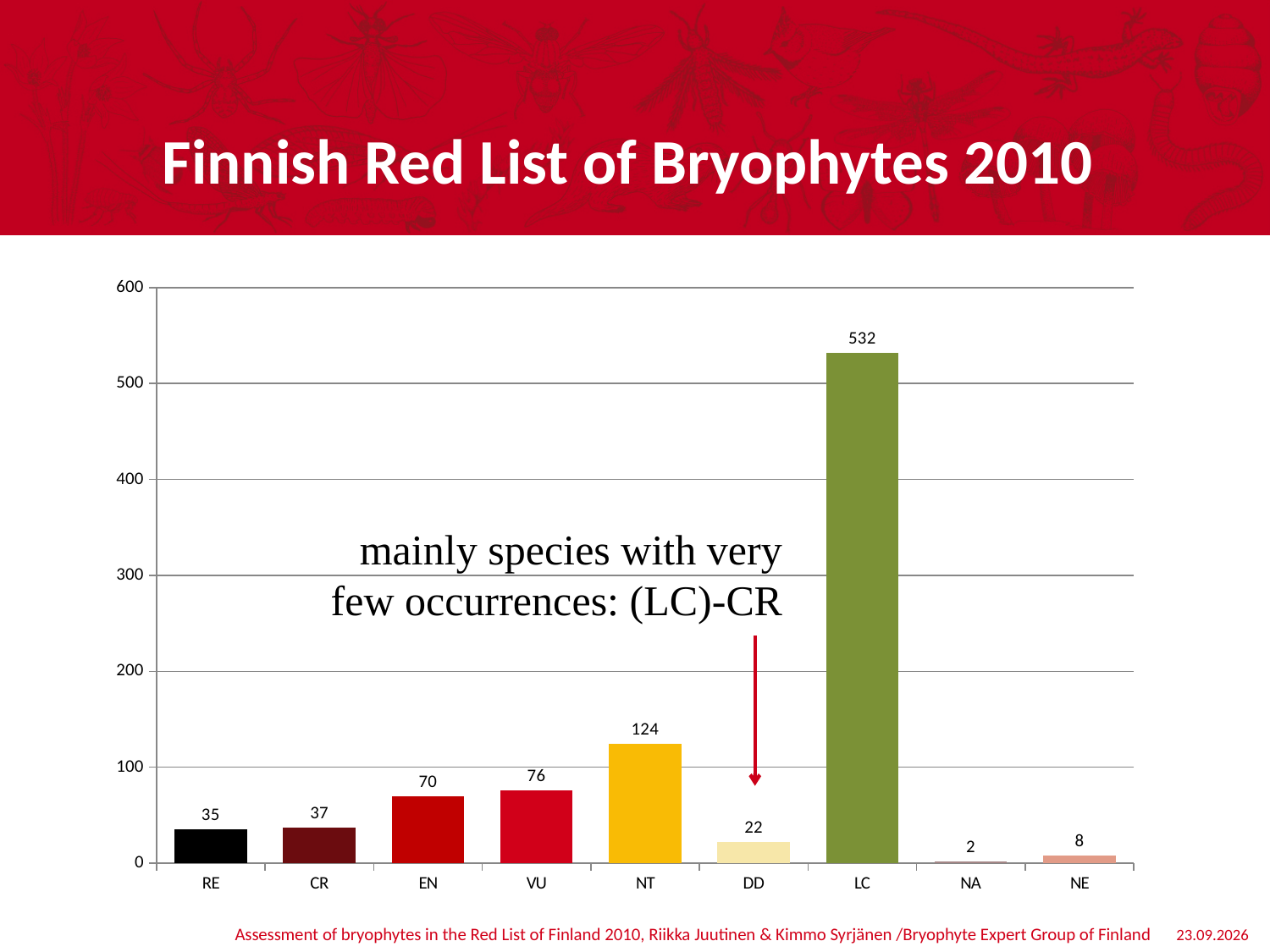
What colour is the bar for LC? green What is the value for NT? 124 What is the total of the values for RE and CR? 72 How many categories are shown on the x axis? 9 What is the value for DD? 22 What is the value for LC? 532 Which category has the lowest value? NA What kind of chart is shown on the slide? bar chart What is the difference between the values for VU and EN? 6 Is the value for NT greater or less than 100? greater Which category has the highest value? LC Which is larger, the value for RE or the value for CR? CR